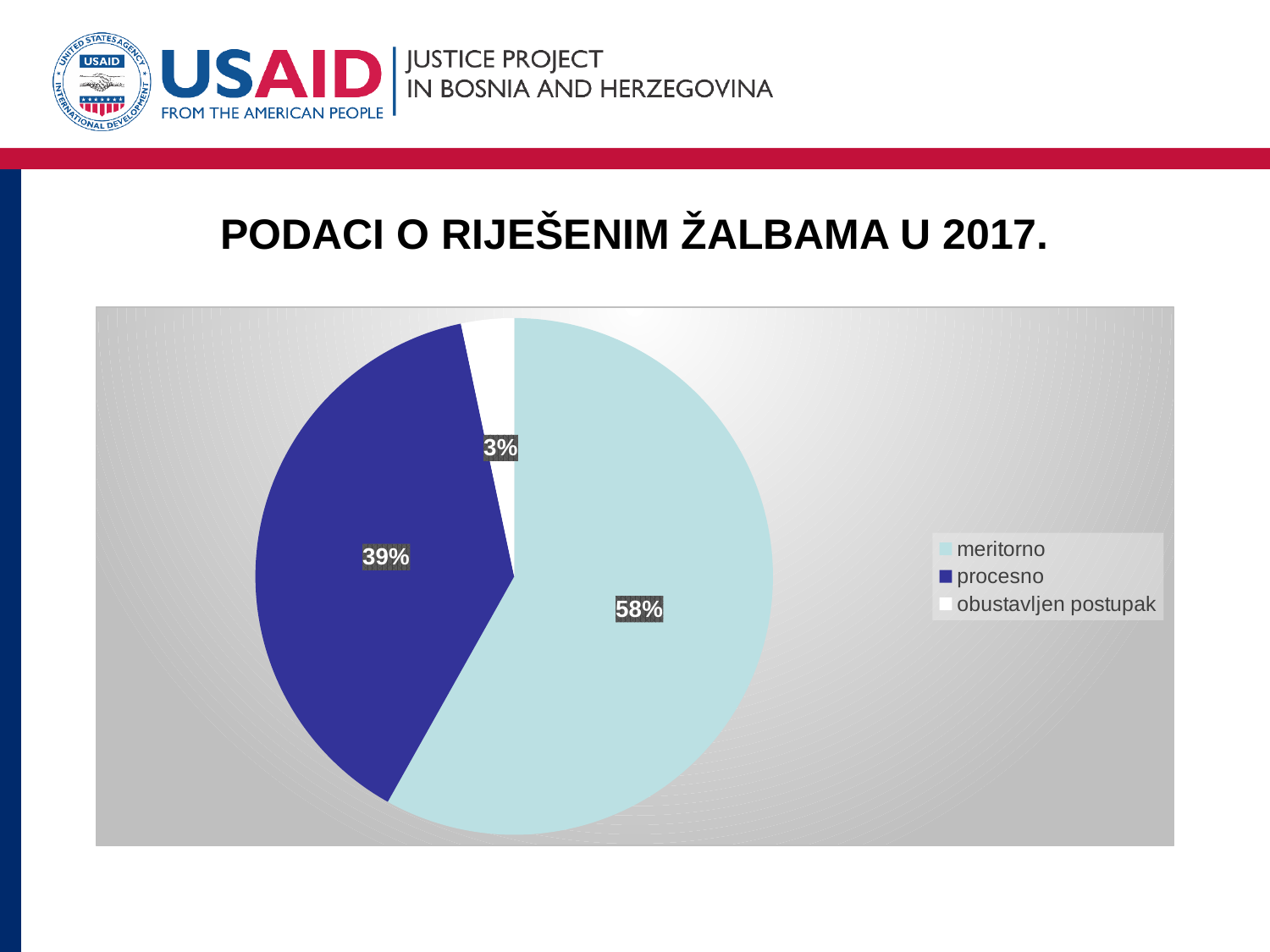
What kind of chart is shown on the slide? pie chart Which legend entry is shown in dark blue? procesno What share of the pie does "meritorno" represent? 58% How many categories does the pie chart show? 3 Which category has the largest slice of the pie? meritorno Which is larger, the share for "procesno" or the share for "obustavljen postupak"? procesno Which category has the smallest slice of the pie? obustavljen postupak How many entries does the legend list? 3 What share of the pie does "procesno" represent? 39% What share of the pie does "obustavljen postupak" represent? 3% What is the difference in percentage points between "meritorno" and "procesno"? 19 What is the title of the slide containing the chart? PODACI O RIJEŠENIM ŽALBAMA U 2017.